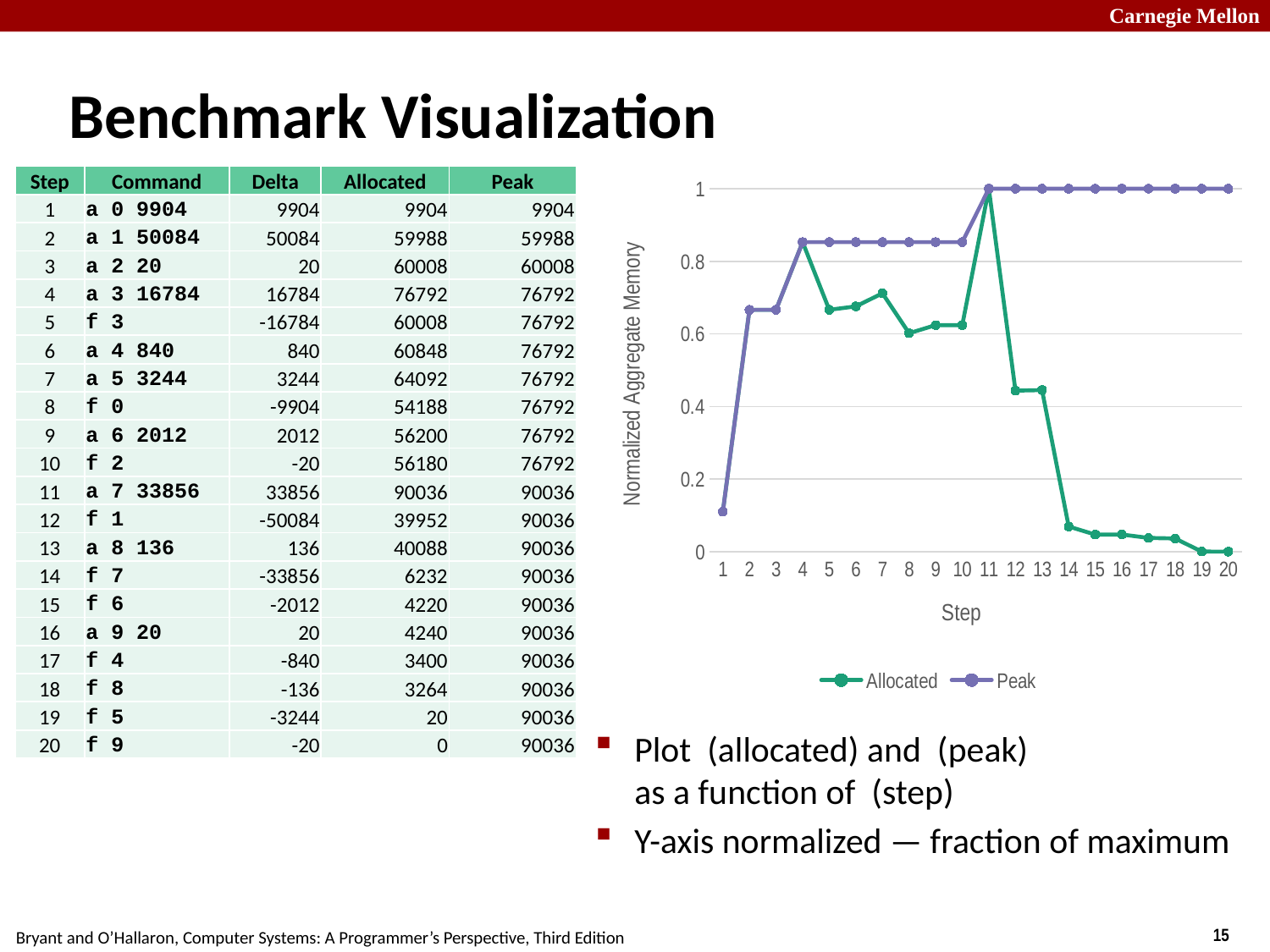
What is the Peak value at step 11 in the chart? 1 How many steps are plotted along the x axis of the chart? 20 What is the Allocated value at step 20 in the chart? 0 What is the label of the y axis of the chart? Normalized Aggregate Memory What kind of chart is shown on the slide? line chart Is the Allocated value at step 14 greater or less than 0.2? less How many series does the chart legend list? 2 At which step does the Allocated series reach its highest value? 11 Does the Allocated series rise or fall from step 11 to step 20? fall Is the Allocated value at step 1 greater or less than 0.2? less At step 12, which series has the larger value, Allocated or Peak? Peak Is the Peak value at step 4 greater or less than 0.8? greater